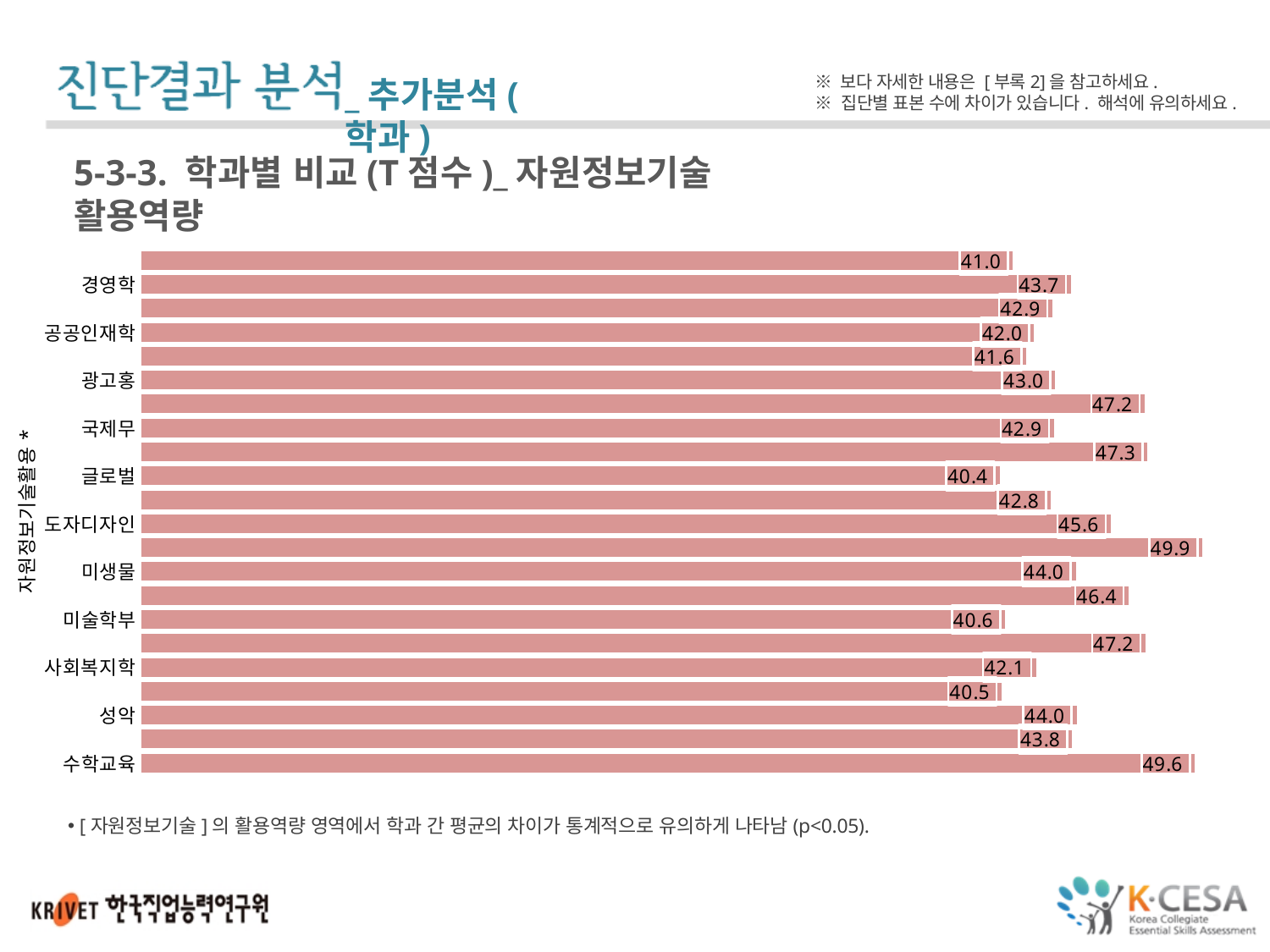
Which has a larger value, 도자디자인 or 미생물? 도자디자인 What is the difference between the values for 수학교육 and 글로벌? 9.2 What is the value for 경영학? 43.7 What is the value for 도자디자인? 45.6 What is the value for 글로벌? 40.4 What kind of chart is shown on the slide? bar chart Which labeled category has the lowest value? 글로벌 What is the highest value shown on any bar in the chart? 49.9 What is the difference between the values for 경영학 and 공공인재학? 1.7 What is the label written along the vertical axis of the chart? 자원정보기술활용* What is the value for 사회복지학? 42.1 What is the value for 수학교육? 49.6